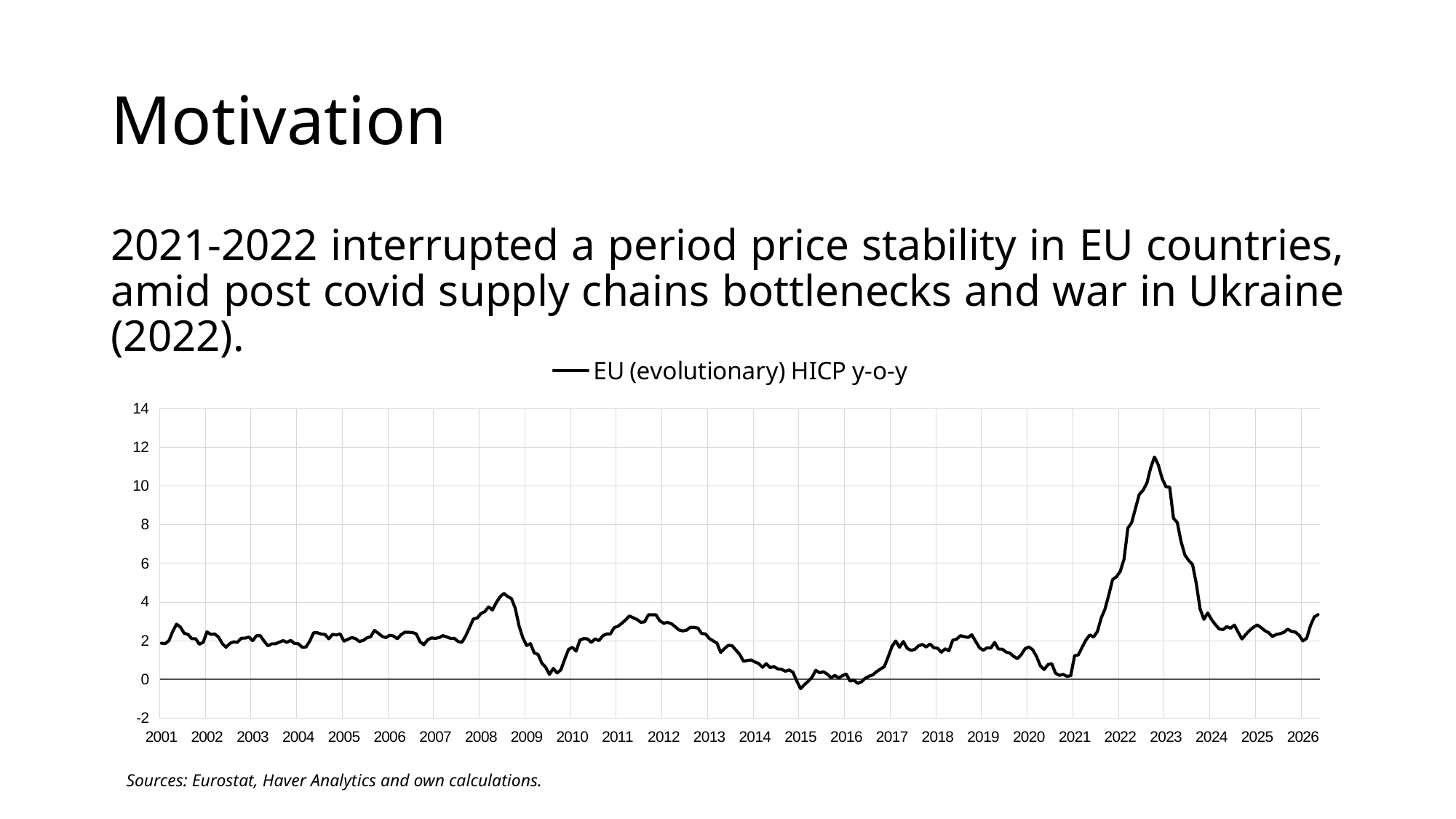
Does the line rise or fall between its 2022 peak and 2024? fall Is the peak value of the line in 2022 greater or less than 10? greater What is the highest value shown on the y axis? 14 In which year does the EU (evolutionary) HICP y-o-y line reach its highest value? 2022 What kind of chart is shown on the slide? line chart How many year labels are shown on the x axis? 26 What is the name of the series shown in the legend? EU (evolutionary) HICP y-o-y Does the line rise or fall between 2021 and its peak in 2022? rise Is the lowest value of the line, around 2015, greater or less than 0? less Is the value of the line in mid-2024 greater or less than 6? less How many series does the legend list? 1